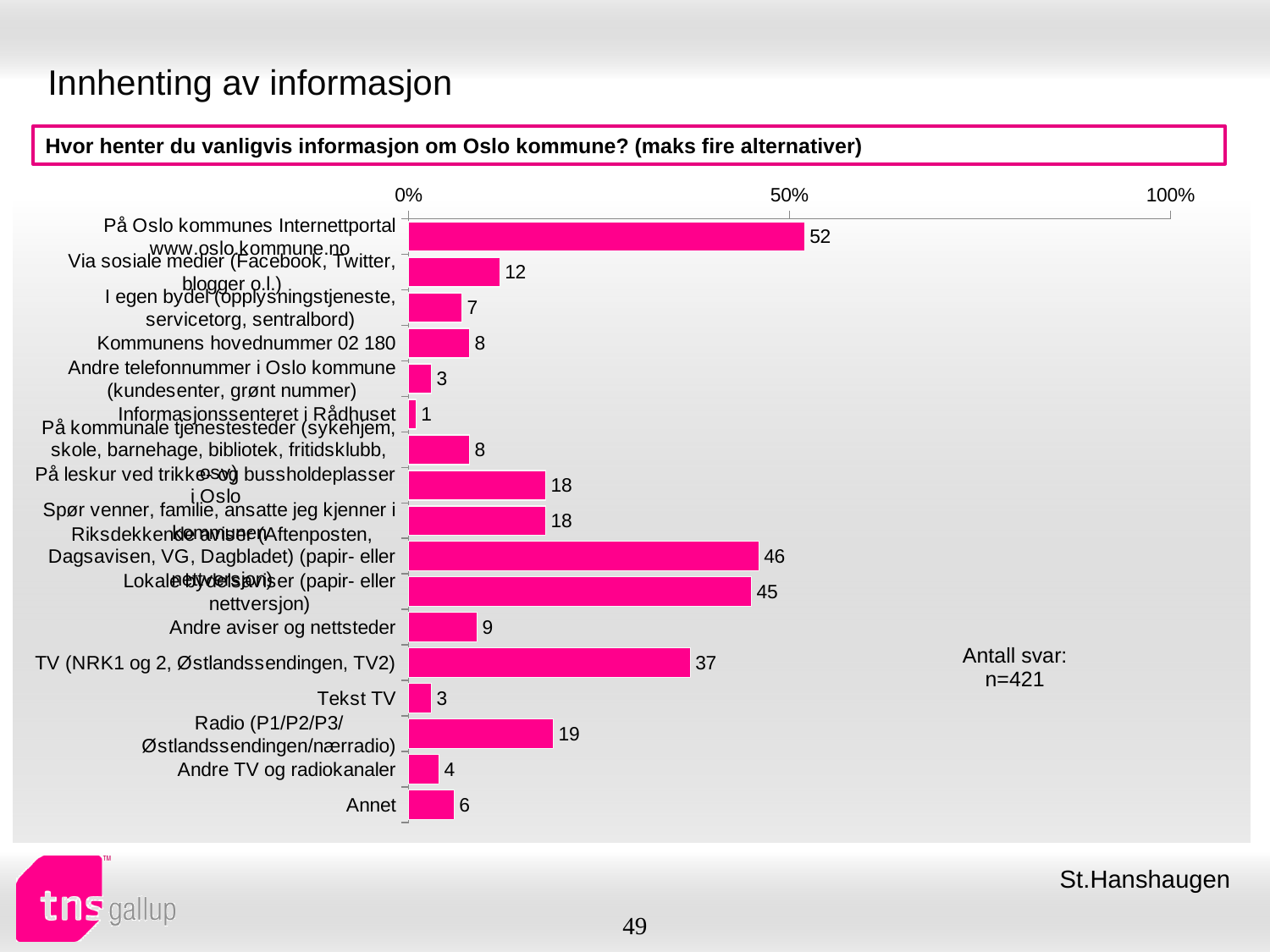
What kind of chart is shown on the slide? bar chart What is the value for 'Kommunens hovednummer 02 180'? 8 Which category has the lowest value? Informasjonssenteret i Rådhuset Is the value for 'På Oslo kommunes Internettportal www.oslo.kommune.no' greater or less than 50%? greater What is the value for 'TV (NRK1 og 2, Østlandssendingen, TV2)'? 37 What is the number of respondents (n) stated on the slide? n=421 What is the value for 'Tekst TV'? 3 Which is larger: the value for 'Radio (P1/P2/P3/Østlandssendingen/nærradio)' or the value for 'Via sosiale medier (Facebook, Twitter, blogger o.l.)'? Radio (P1/P2/P3/Østlandssendingen/nærradio) What is the value for 'Annet'? 6 What is the difference between the value for 'På Oslo kommunes Internettportal www.oslo.kommune.no' and the value for 'TV (NRK1 og 2, Østlandssendingen, TV2)'? 15 Which category has the highest value? På Oslo kommunes Internettportal www.oslo.kommune.no How many categories are shown in the chart? 17